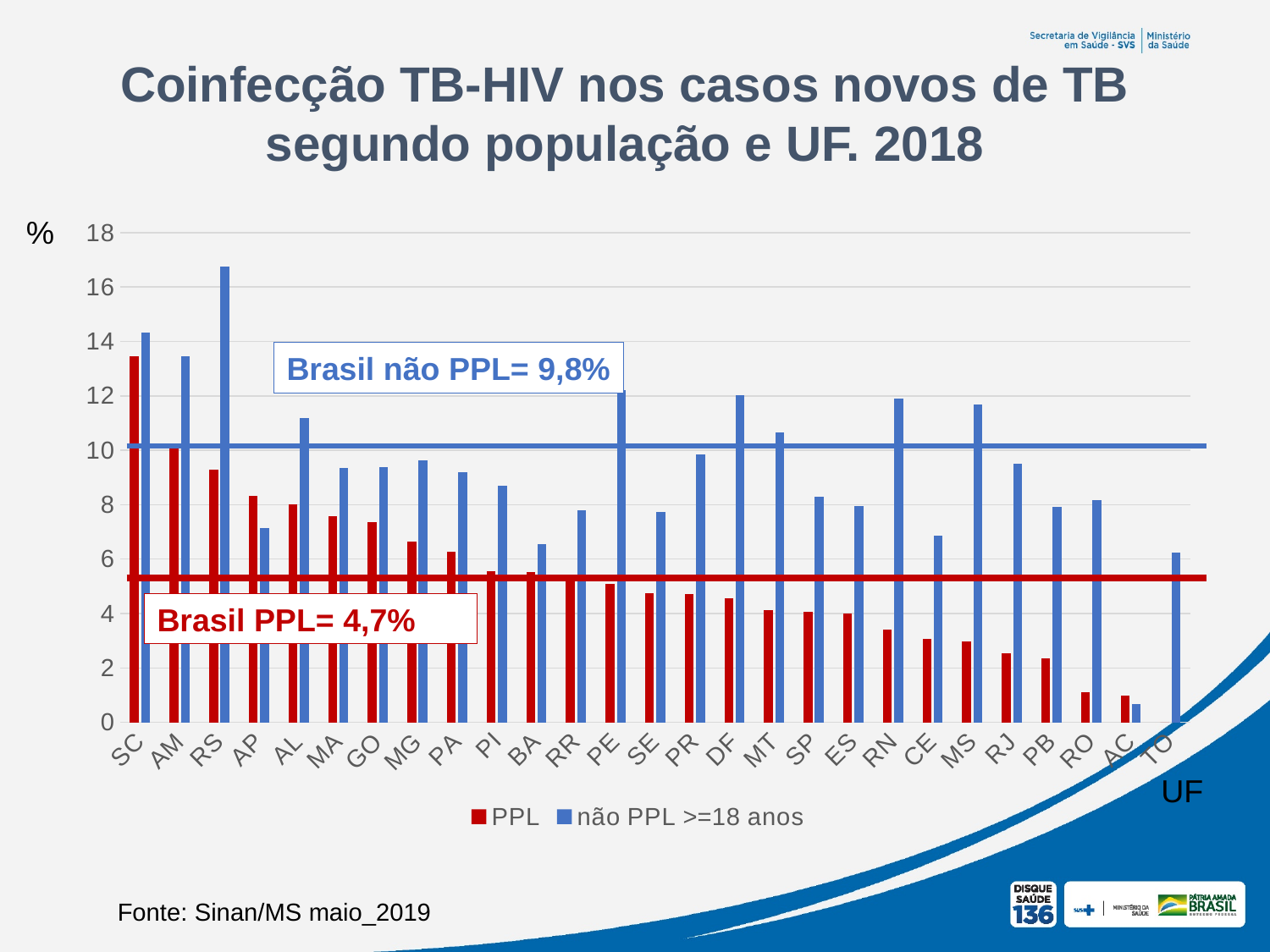
How many UFs (categories) are shown on the x axis? 27 What kind of chart is shown on the slide? bar chart Is the 'não PPL >=18 anos' value for RS greater or less than 16? greater Is the PPL value for AC greater or less than 2? less Which is larger, the PPL value for SC or the PPL value for AM? SC What value is given for 'Brasil não PPL' in the annotation on the chart? 9,8% Which UF has the highest value for the PPL series? SC How many series does the legend list? 2 Do the PPL values generally rise or fall from left to right along the x axis? fall Which UF has the highest value for the 'não PPL >=18 anos' series? RS Which UF has the lowest value for the 'não PPL >=18 anos' series? AC Is the PPL value for SC greater or less than 12? greater